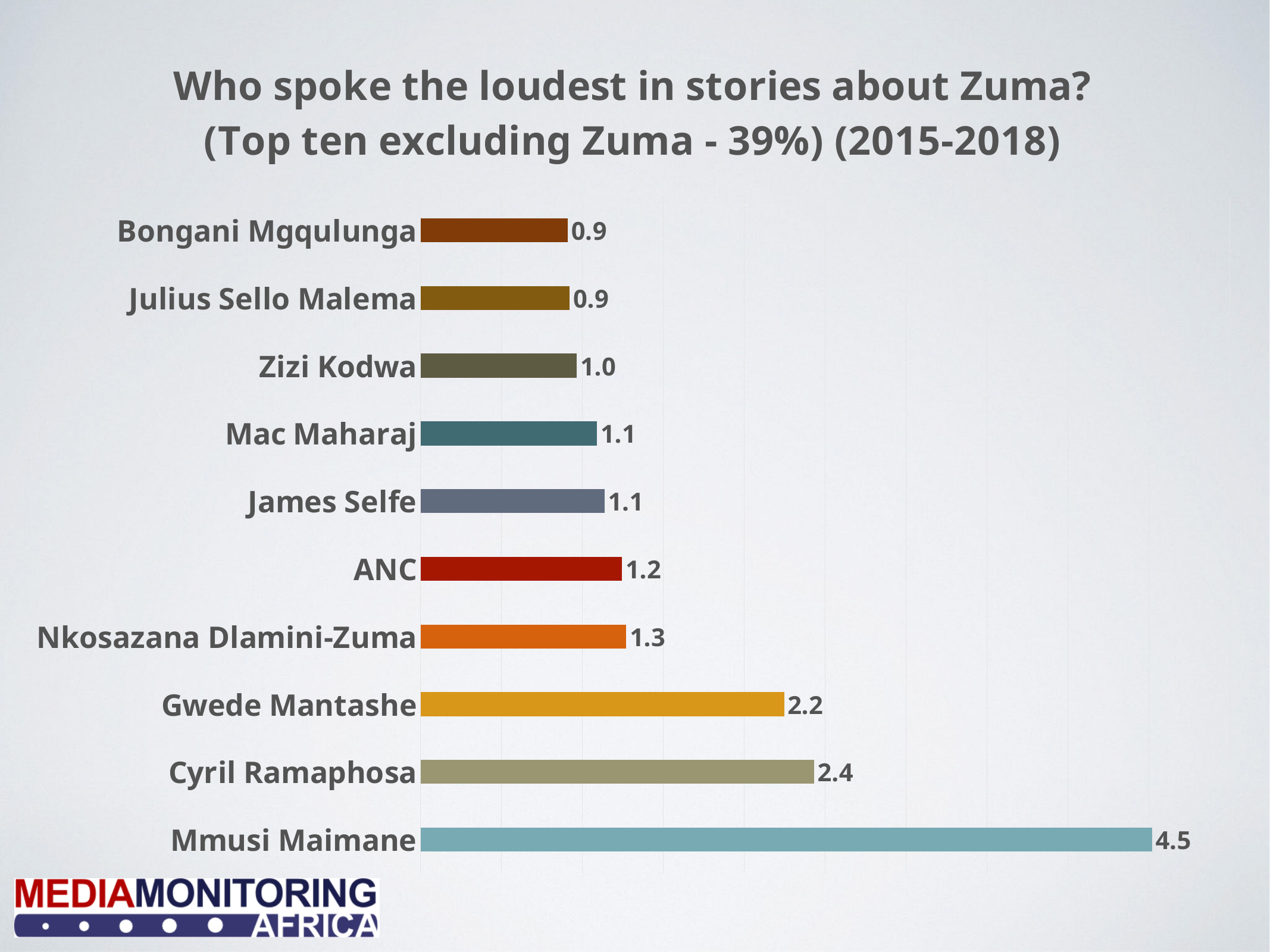
What kind of chart is shown on the slide? bar chart What is the value for Zizi Kodwa? 1.0 Which is larger, the value for Cyril Ramaphosa or the value for Gwede Mantashe? Cyril Ramaphosa What is the difference between the values for Gwede Mantashe and ANC? 1.0 What is the title of the chart? Who spoke the loudest in stories about Zuma? (Top ten excluding Zuma - 39%) (2015-2018) What is the value for Gwede Mantashe? 2.2 What is the difference between the values for Mmusi Maimane and Cyril Ramaphosa? 2.1 How many categories are shown in the chart? 10 Which category has the highest value? Mmusi Maimane What is the value for Nkosazana Dlamini-Zuma? 1.3 What is the value for Mmusi Maimane? 4.5 Which is larger, the value for ANC or the value for Julius Sello Malema? ANC